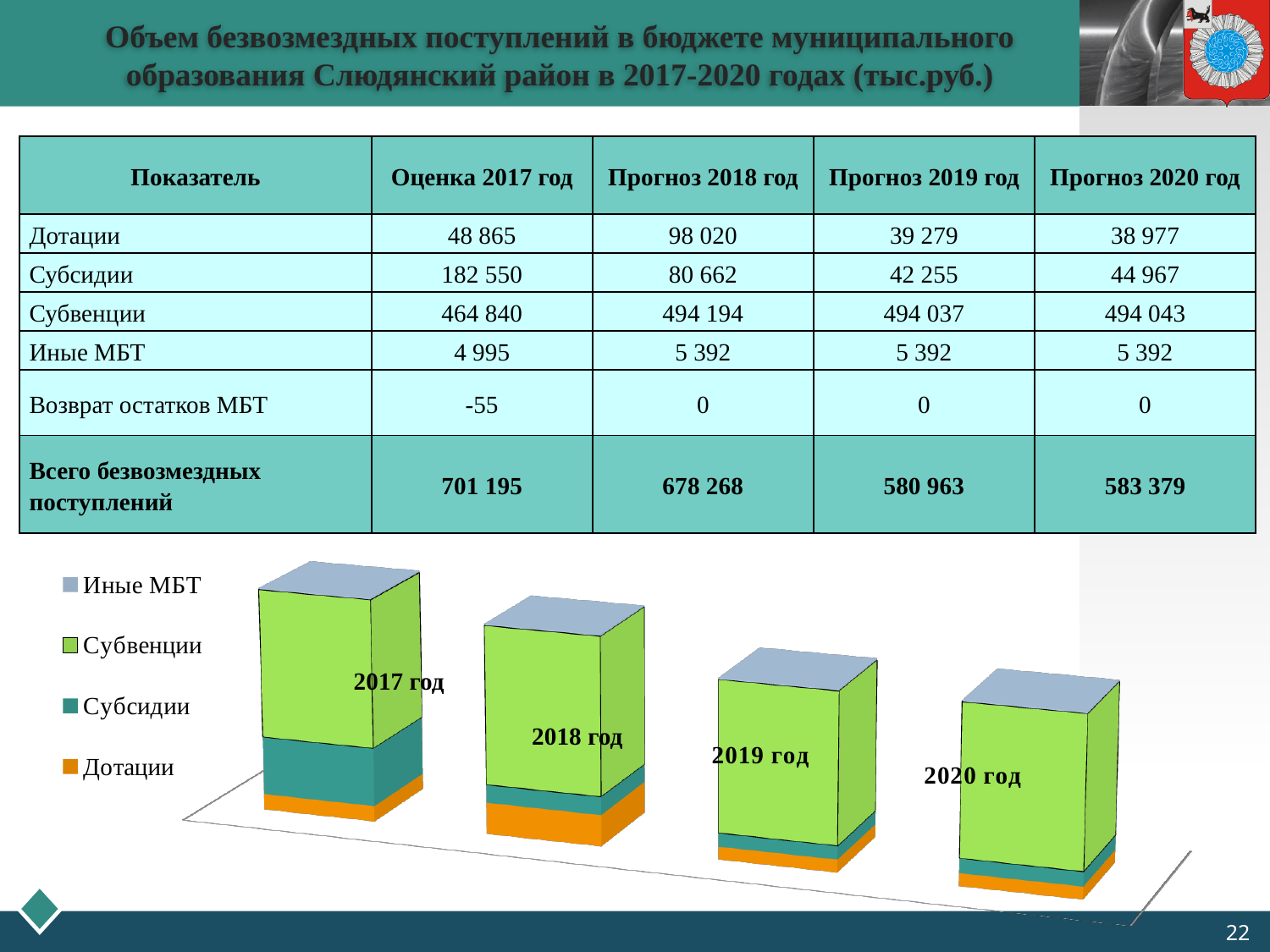
Is the Субсидии segment larger in the 2017 bar or in the 2018 bar? 2017 год Which legend entry is shown with the orange colour in the chart? Дотации How many series does the chart legend list? 4 Which series forms the largest segment in every bar of the chart? Субвенции Is the Дотации segment larger in the 2017 bar or in the 2018 bar? 2018 год Which year has the tallest stacked bar in the chart? 2017 год According to the slide, what is the value of Субвенции for Прогноз 2018 год? 494 194 Does the total height of the bars rise or fall from 2017 to 2019? fall How many bars (years) are plotted in the chart? 4 According to the slide, what is the total of all безвозмездные поступления for Оценка 2017 год? 701 195 Which legend entry is shown with the light green colour in the chart? Субвенции What kind of chart is shown at the bottom of the slide? stacked bar chart